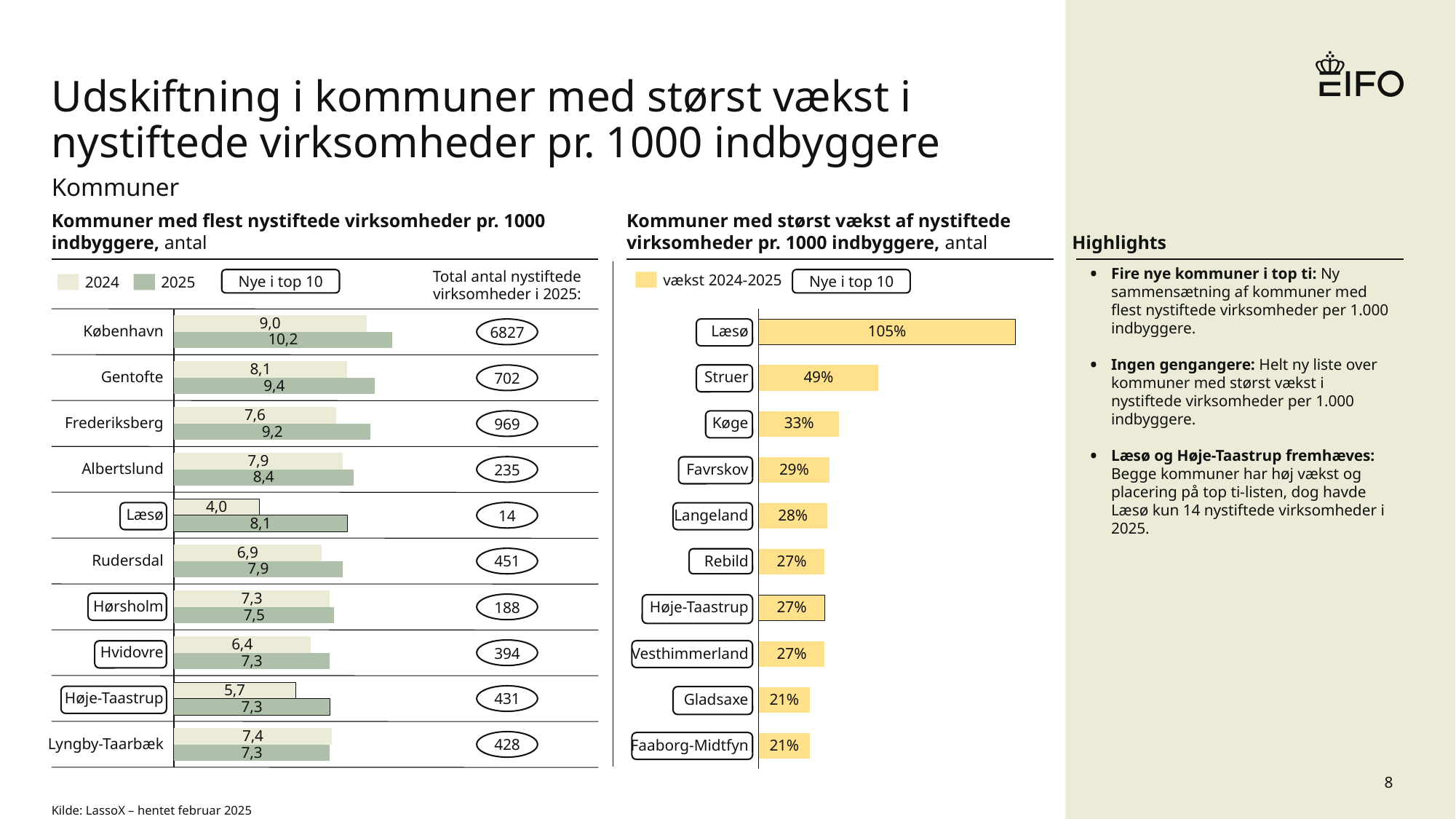
In the left chart (Kommuner med flest nystiftede virksomheder pr. 1000 indbyggere), what is the difference between the 2025 and 2024 values for Høje-Taastrup? 1,6 In the right chart (Kommuner med størst vækst af nystiftede virksomheder pr. 1000 indbyggere), what is the growth value for Struer? 49% In the right chart (Kommuner med størst vækst af nystiftede virksomheder pr. 1000 indbyggere), how many kommuner are shown? 10 In the left chart (Kommuner med flest nystiftede virksomheder pr. 1000 indbyggere), what is the 2025 value for København? 10,2 In the left chart (Kommuner med flest nystiftede virksomheder pr. 1000 indbyggere), which kommune has the highest 2025 value? København In the right chart (Kommuner med størst vækst af nystiftede virksomheder pr. 1000 indbyggere), which kommune has the highest growth? Læsø What type of chart is the right chart (Kommuner med størst vækst af nystiftede virksomheder pr. 1000 indbyggere)? Bar chart In the left chart (Kommuner med flest nystiftede virksomheder pr. 1000 indbyggere), how many series does the legend list? 2 In the left chart (Kommuner med flest nystiftede virksomheder pr. 1000 indbyggere), which is larger for Lyngby-Taarbæk: the 2024 value or the 2025 value? 2024 In the left chart (Kommuner med flest nystiftede virksomheder pr. 1000 indbyggere), what is the total number of newly founded companies in 2025 shown for Frederiksberg? 969 In the left chart (Kommuner med flest nystiftede virksomheder pr. 1000 indbyggere), which kommune has the lowest 2024 value? Læsø In the left chart (Kommuner med flest nystiftede virksomheder pr. 1000 indbyggere), what is the 2024 value for Læsø? 4,0